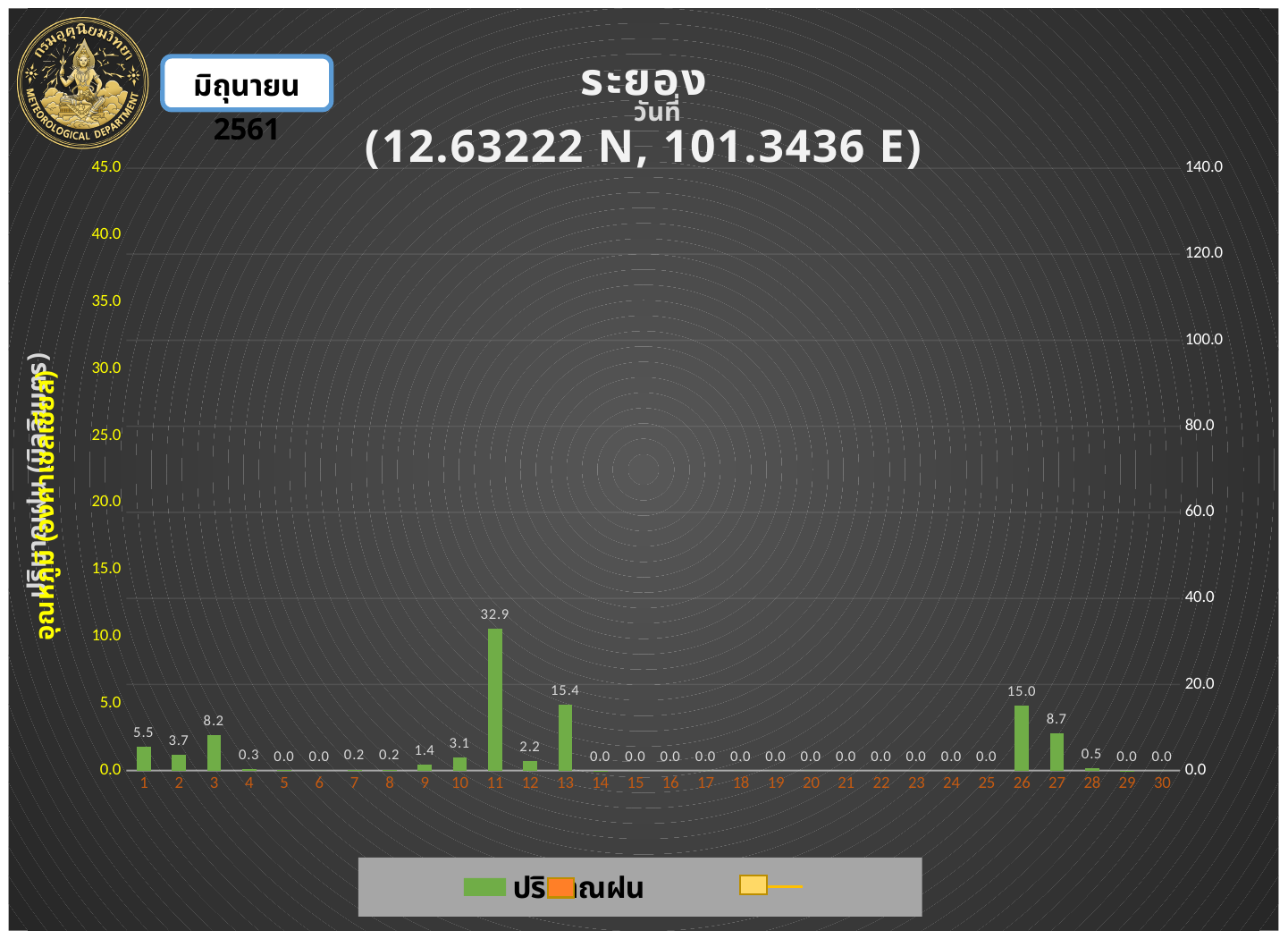
Which day has the highest value in the chart? 11 What coordinates are given in the chart title? 12.63222 N, 101.3436 E What is the value shown for day 26? 15.0 What is the difference between the values for day 26 and day 27? 6.3 How many days are shown on the x axis of the chart? 30 What is the difference between the values for day 11 and day 13? 17.5 What is the value shown for day 13? 15.4 What is the rainfall value shown for day 11? 32.9 What is the value shown for day 3? 8.2 Which is larger, the value for day 27 or the value for day 3? day 27 What is the value shown for day 1? 5.5 What kind of chart is shown on the slide? bar chart